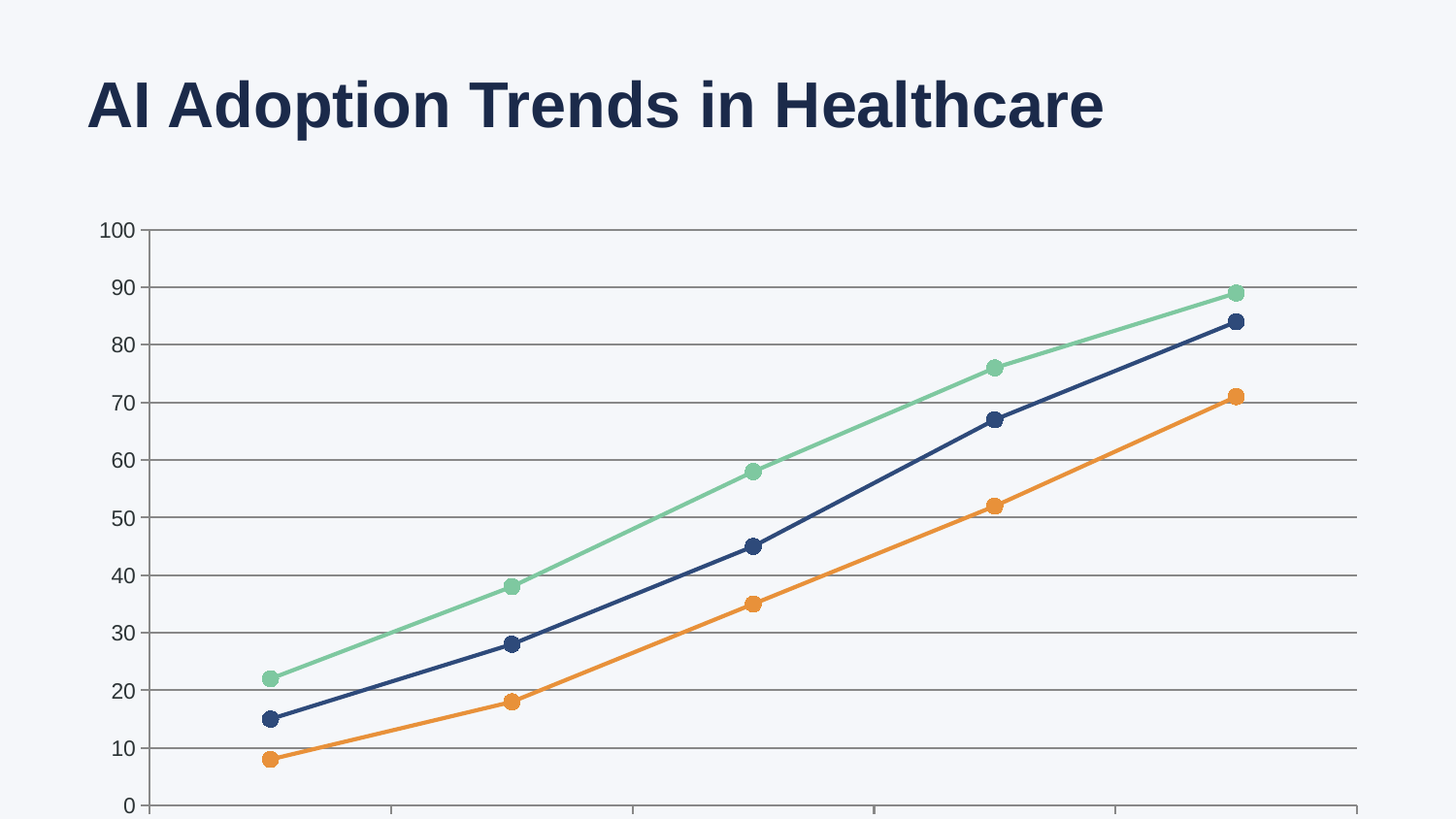
Is the first point of the orange line greater or less than 10? less What is the title of the chart on the slide? AI Adoption Trends in Healthcare Which line has the highest value at the final point: green, dark blue or orange? green Which line has the lowest value at the first point: green, dark blue or orange? orange What kind of chart is shown on the slide? line chart Is the third point of the green line greater or less than 50? greater Is the last point of the green line greater or less than 80? greater Do the values of the lines rise or fall from left to right along the x axis? rise How many lines are plotted on the chart? 3 How many data points does each line have? 5